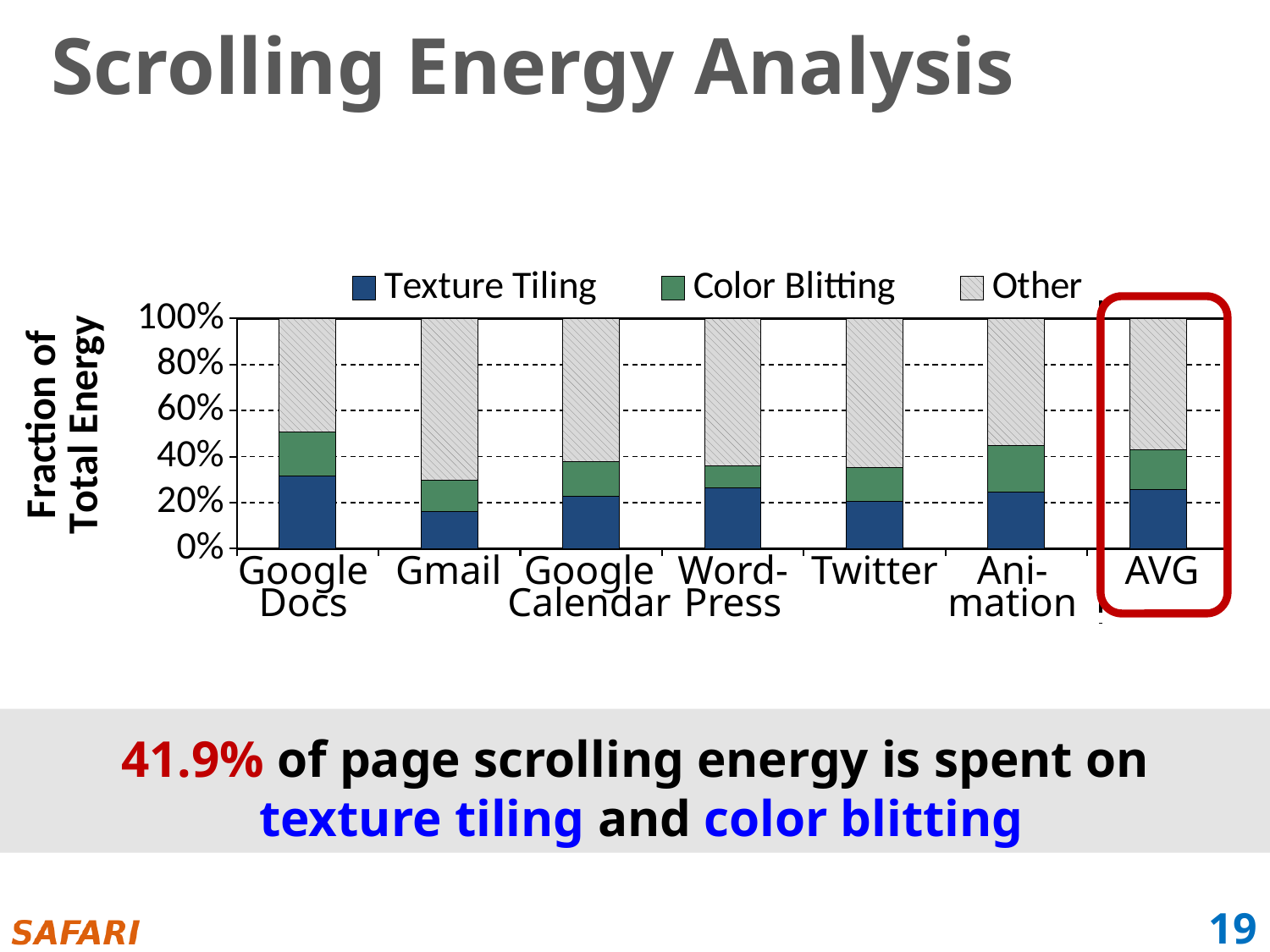
Which category has the largest Texture Tiling share? Google Docs How many series does the chart's legend list? 3 Is the Texture Tiling value for Google Docs greater or less than 20%? greater How many categories are shown along the x axis of the chart? 7 Is the Texture Tiling value for Gmail greater or less than 20%? less Which category on the x axis is highlighted with a red box? AVG What kind of chart is shown on the slide? Stacked bar chart What are the three series listed in the chart's legend? Texture Tiling, Color Blitting, Other Is the combined Texture Tiling and Color Blitting share for Google Docs greater or less than 40%? greater Which has the larger Texture Tiling share, Google Docs or Gmail? Google Docs Which category has the smallest Texture Tiling share? Gmail